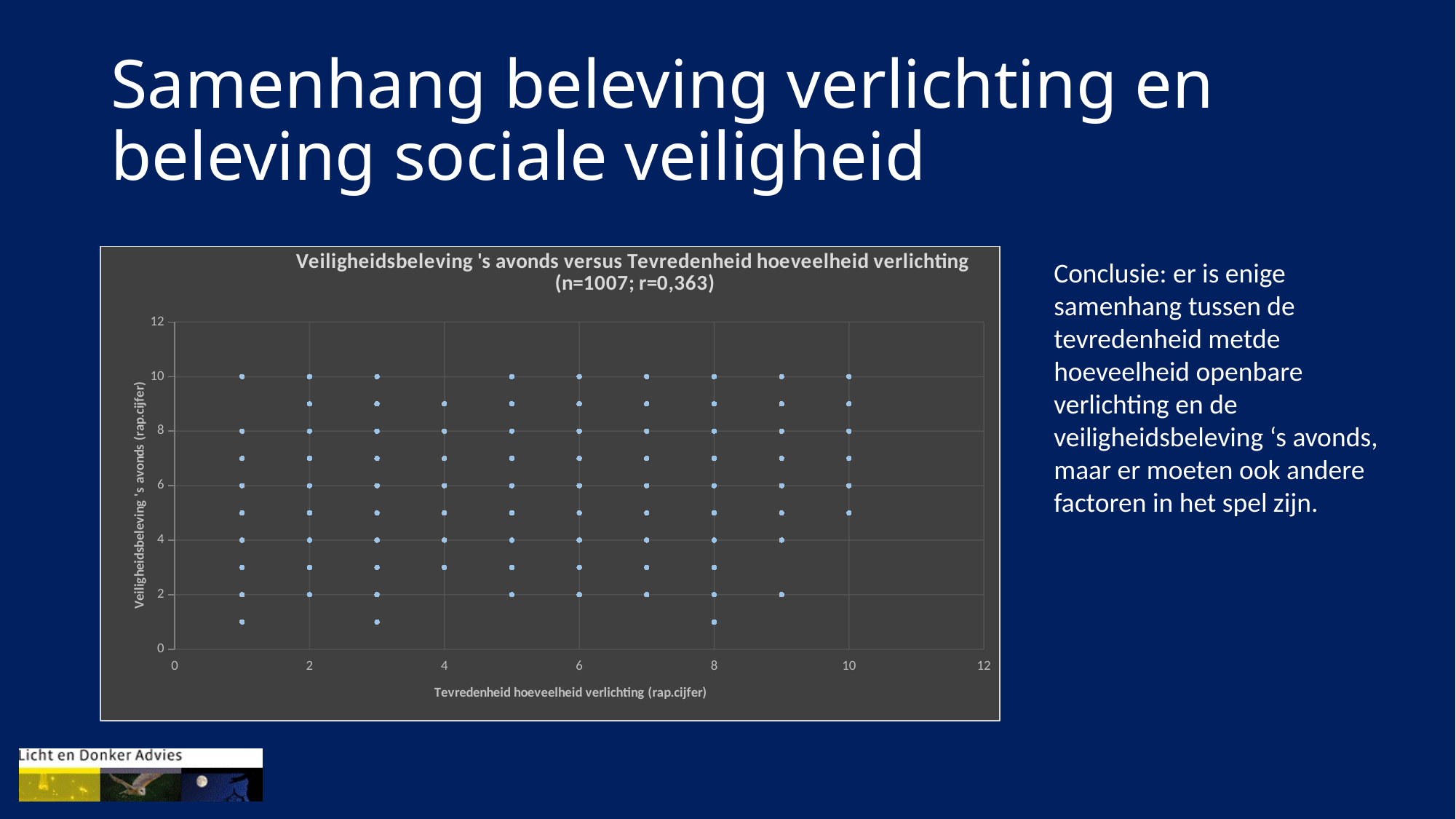
What is the highest value shown on the y axis? 12 What is the highest y value plotted at x = 4? 9 What is the lowest y value (Veiligheidsbeleving 's avonds) reached by any point in the chart? 1 What is the highest y value (Veiligheidsbeleving 's avonds) reached by any point in the chart? 10 What kind of chart is shown on the slide? scatter plot What is the lowest y value plotted at x = 10? 5 How many points are plotted at x = 10 (Tevredenheid hoeveelheid verlichting)? 6 What is the highest x value (Tevredenheid hoeveelheid verlichting) at which a point is plotted? 10 What is the lowest x value (Tevredenheid hoeveelheid verlichting) at which a point is plotted? 1 Is the lowest y value plotted at x = 10 greater or less than 4? greater What is the sample size (n) stated in the chart title? 1007 What correlation coefficient (r) is stated in the chart title? 0,363